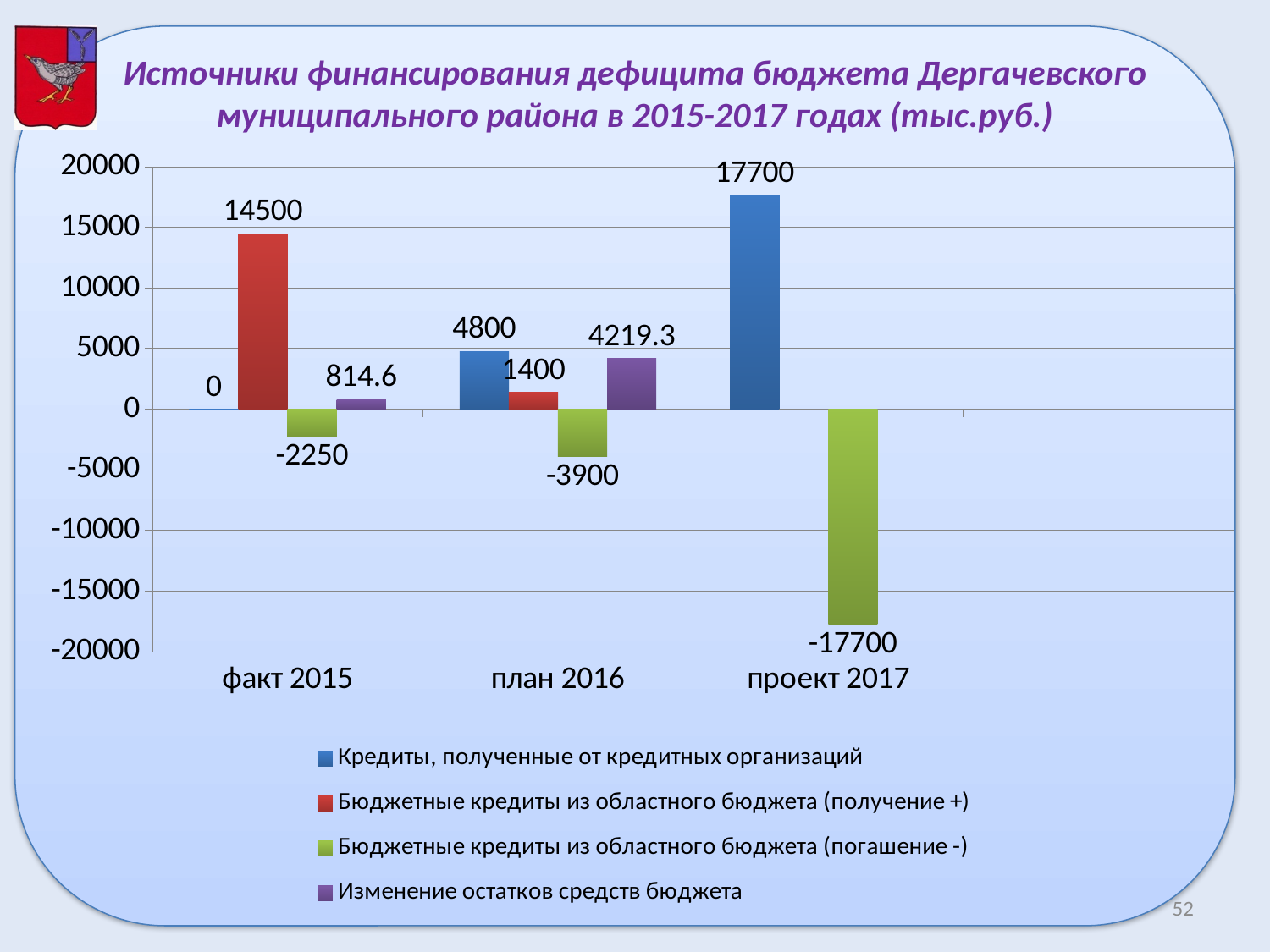
How many series does the legend list? 4 Which is larger: 'Кредиты, полученные от кредитных организаций' in 'план 2016' or 'Изменение остатков средств бюджета' in 'план 2016'? Кредиты, полученные от кредитных организаций In which category is the value for 'Бюджетные кредиты из областного бюджета (погашение -)' lowest? проект 2017 What value is shown for 'Бюджетные кредиты из областного бюджета (получение +)' in 'факт 2015'? 14500 What value is shown for 'Кредиты, полученные от кредитных организаций' in 'проект 2017'? 17700 What value is shown for 'Кредиты, полученные от кредитных организаций' in 'факт 2015'? 0 What value is shown for 'Изменение остатков средств бюджета' in 'план 2016'? 4219.3 How many categories are shown on the x axis? 3 What value is shown for 'Бюджетные кредиты из областного бюджета (погашение -)' in 'проект 2017'? -17700 What kind of chart is shown on the slide? bar chart What is the difference between 'Бюджетные кредиты из областного бюджета (получение +)' in 'факт 2015' and in 'план 2016'? 13100 In which category is the value for 'Кредиты, полученные от кредитных организаций' highest? проект 2017